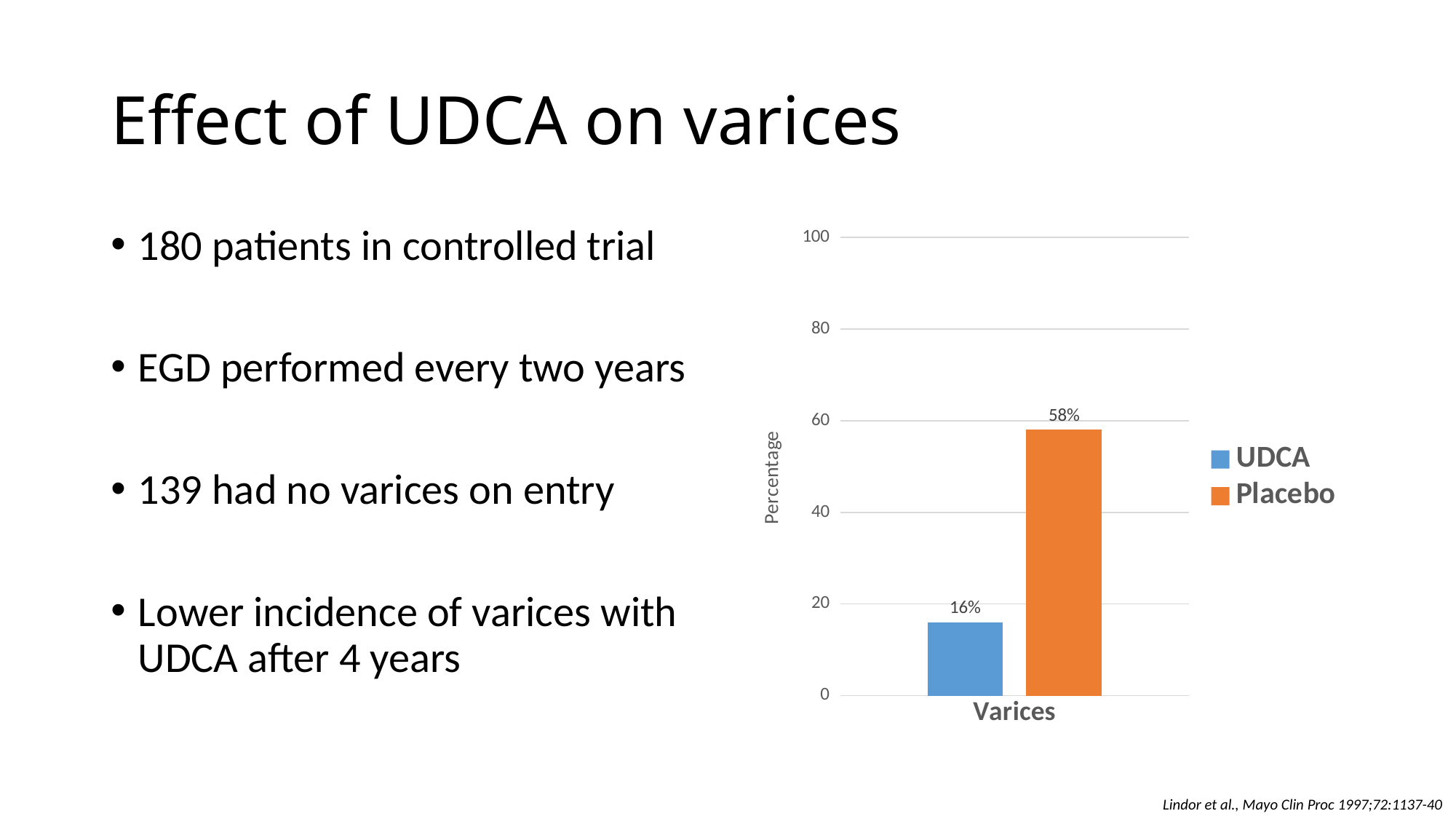
Which series has the higher value for Varices, UDCA or Placebo? Placebo Is the value for Placebo greater or less than 40? greater How many series does the legend list? 2 What is the value for UDCA in the Varices category? 16% What is the value for Placebo in the Varices category? 58% Which series has the lowest value in the chart? UDCA What colour is the Placebo bar? Orange What is the difference between the Placebo and UDCA values for Varices? 42% Is the value for UDCA greater or less than 20? less What kind of chart is shown on the slide? Bar chart What is the label of the y axis? Percentage How many categories are shown on the x axis? 1